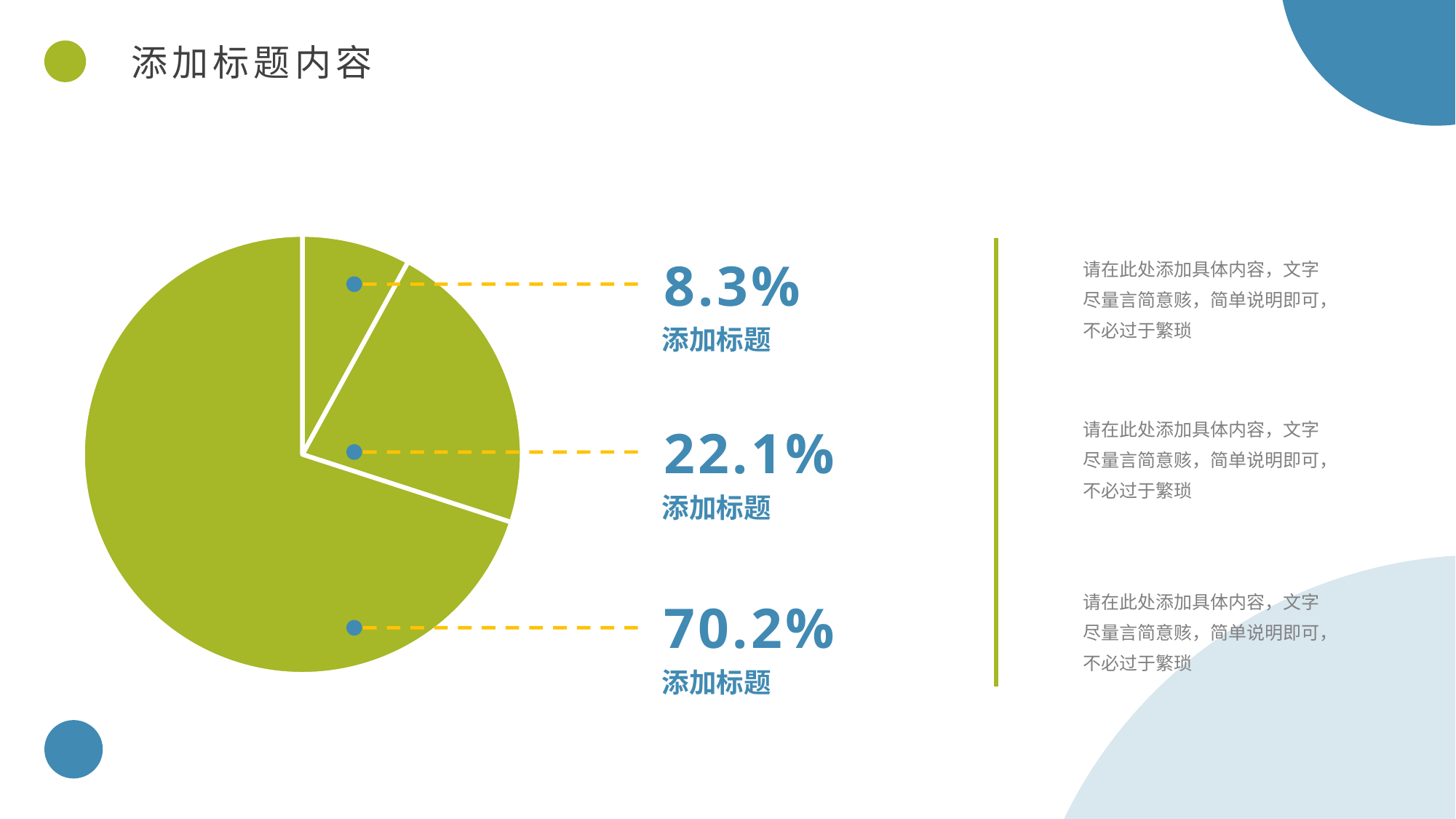
What is the smallest percentage labelled on the pie chart? 8.3% What percentage is shown for the slice connected to the top callout? 8.3% What kind of chart is shown on the slide? pie chart What colour are the slices of the pie chart? green What percentage is shown for the slice connected to the bottom callout? 70.2% How many slices does the pie chart have? 3 What is the largest percentage labelled on the pie chart? 70.2% What is the difference between the largest slice (70.2%) and the middle slice (22.1%)? 48.1% Does the largest slice of the pie account for more or less than half of the pie? more Which slice is larger, the one labelled 22.1% or the one labelled 8.3%? 22.1% What is the difference between the 22.1% slice and the 8.3% slice? 13.8% What percentage is shown for the slice connected to the middle callout? 22.1%